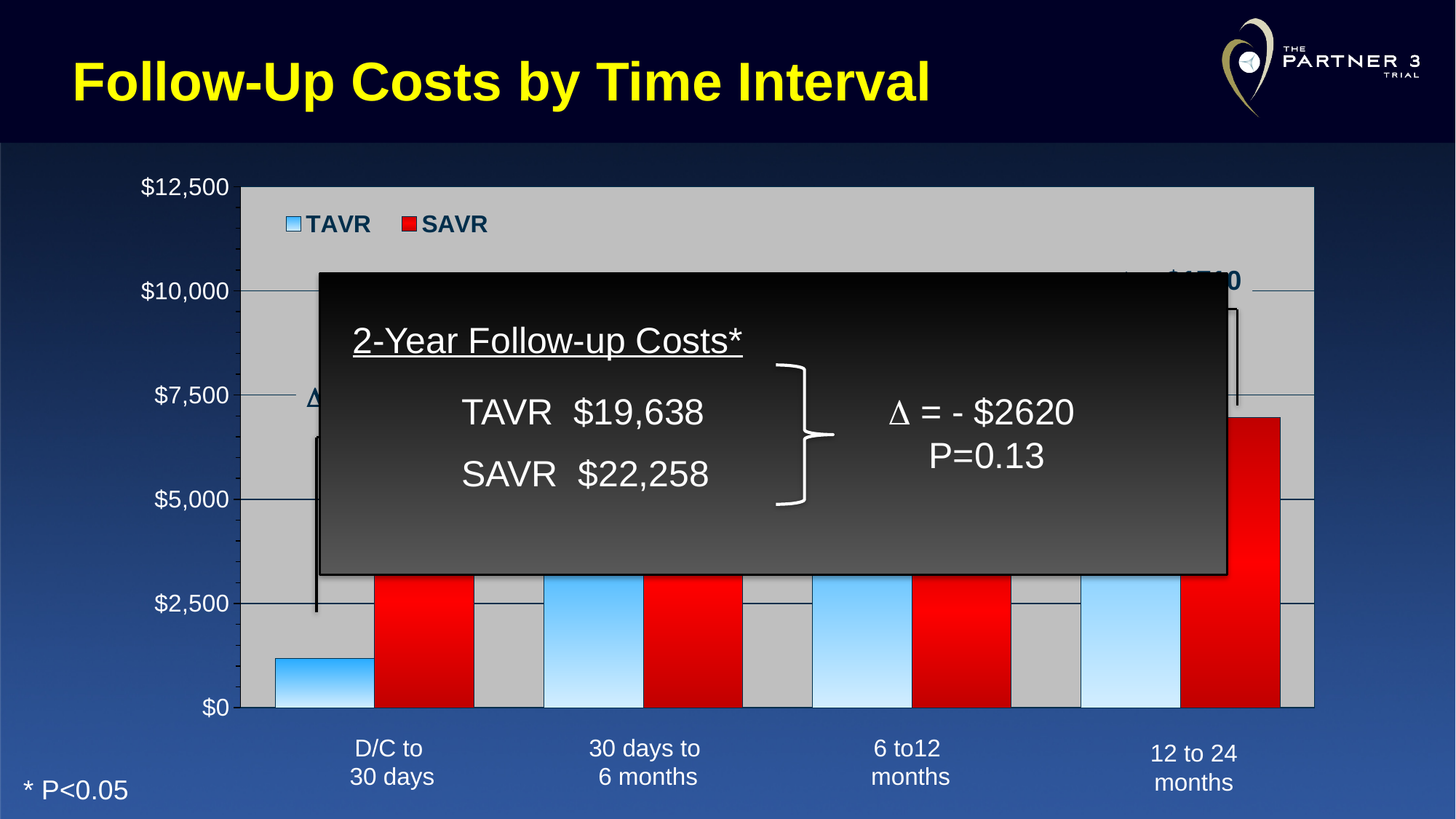
What kind of chart is shown on the slide? bar chart Which is larger, the TAVR bar for D/C to 30 days or the SAVR bar for 12 to 24 months? SAVR bar for 12 to 24 months Is the SAVR value for 12 to 24 months greater or less than $7,500? less Which bar on the chart is the lowest? TAVR, D/C to 30 days How many series does the chart legend list? 2 How many time-interval categories are shown on the x axis? 4 What are the two series named in the chart legend? TAVR and SAVR According to the overlay box, what is the 2-year follow-up cost for TAVR? $19,638 In the D/C to 30 days interval, which is larger, the TAVR bar or the SAVR bar? SAVR Is the SAVR value for 12 to 24 months greater or less than $5,000? greater Is the TAVR value for D/C to 30 days greater or less than $2,500? less